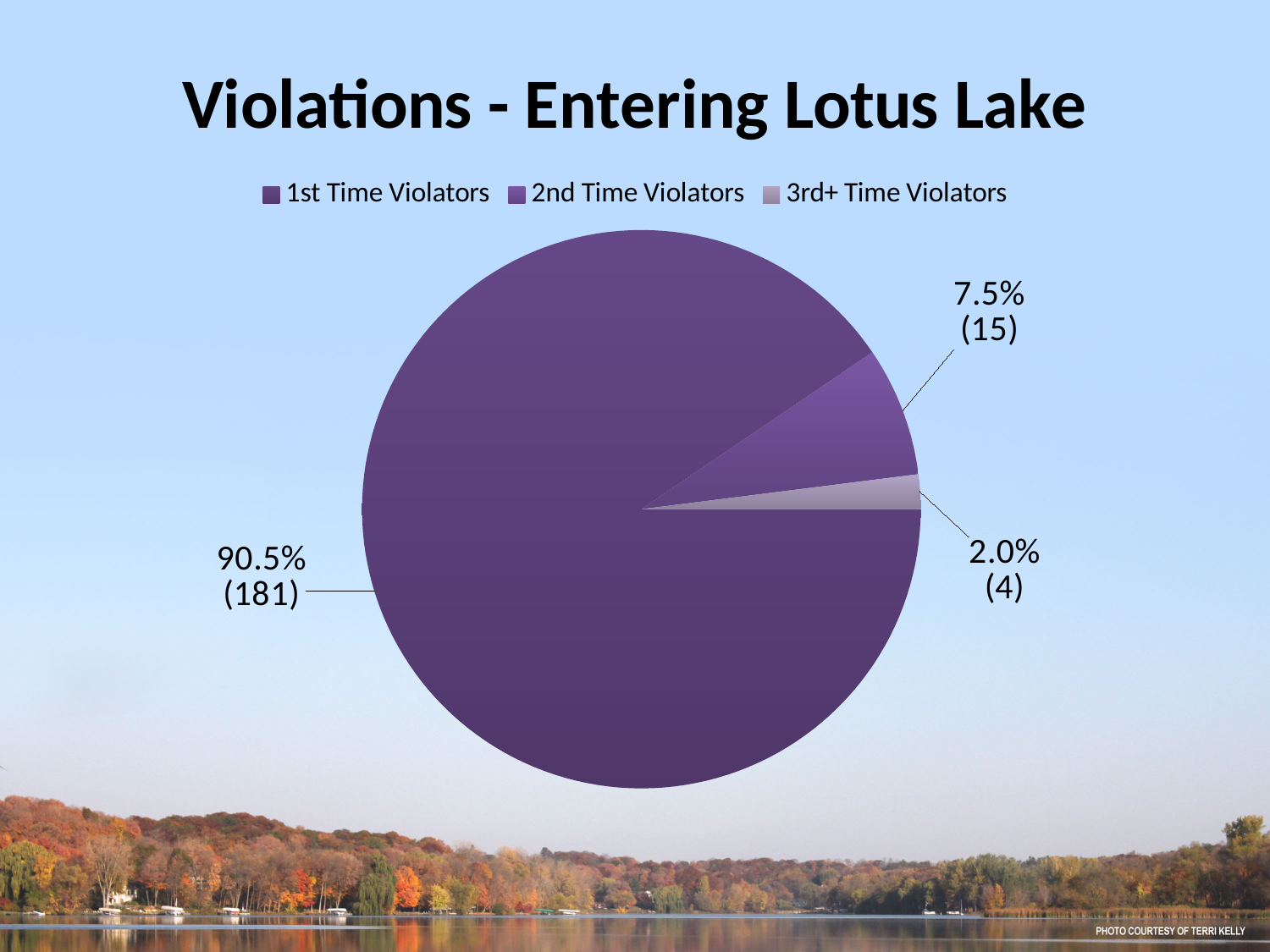
Which category has the smallest slice of the pie? 3rd+ Time Violators How many categories does the legend list? 3 What percentage of violations are 3rd+ Time Violators? 2.0% How many 1st Time Violators are shown? 181 Which category has the largest slice of the pie? 1st Time Violators How many 2nd Time Violators are shown? 15 What percentage of violations are 1st Time Violators? 90.5% How many 3rd+ Time Violators are shown? 4 What is the title of the chart? Violations - Entering Lotus Lake What percentage of violations are 2nd Time Violators? 7.5% What is the difference in count between 2nd Time Violators and 3rd+ Time Violators? 11 What type of chart is shown on the slide? pie chart